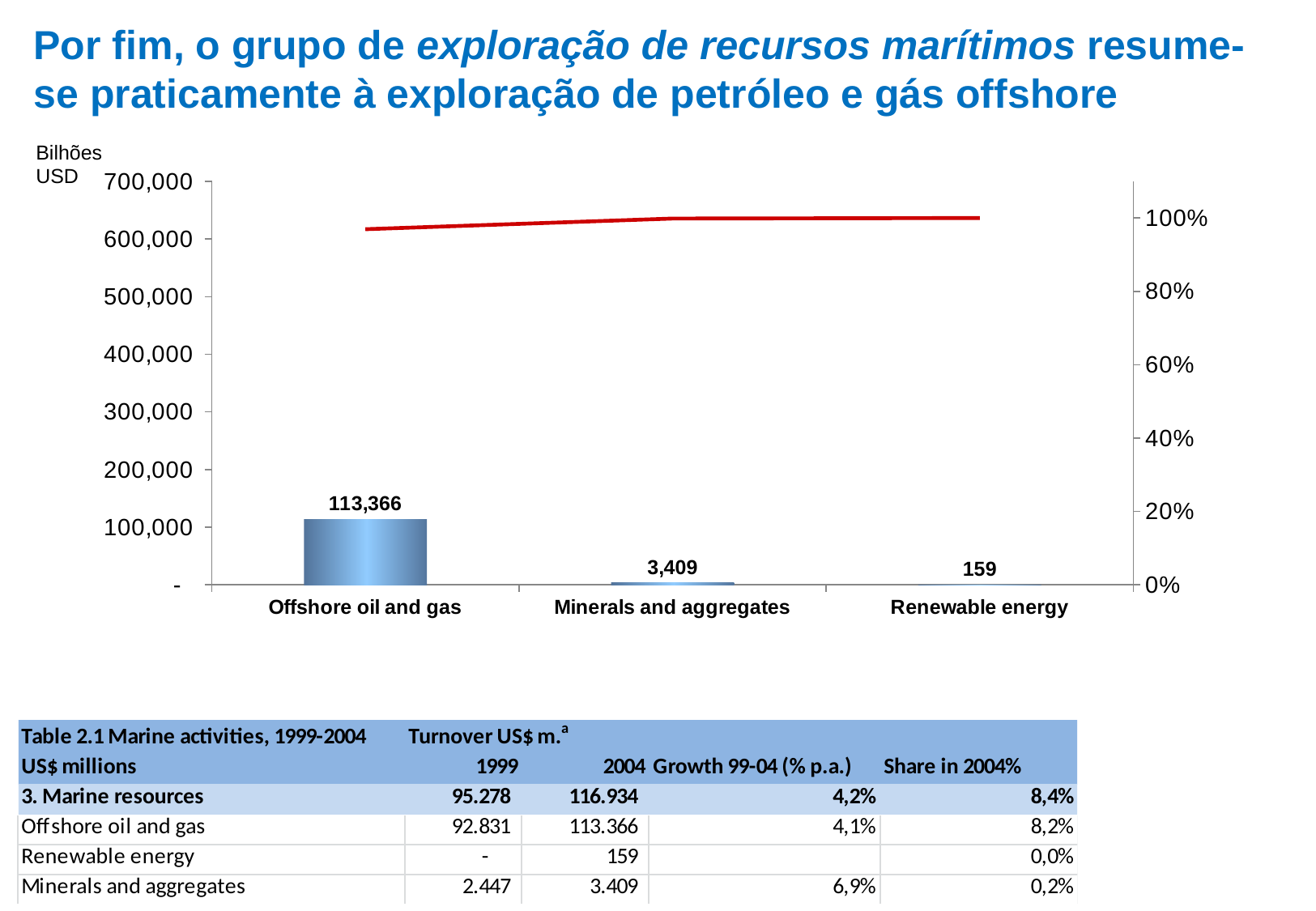
How many categories are shown on the x axis of the chart? 3 What kind of chart is shown on the slide? bar chart with a line What is the difference between the bar values for Minerals and aggregates and Renewable energy? 3,250 What is the value of the bar for Minerals and aggregates? 3,409 Which category has the lowest bar? Renewable energy Which category has the highest bar? Offshore oil and gas Is the bar value for Offshore oil and gas greater or less than 100,000? greater What is the value of the bar for Offshore oil and gas? 113,366 What is the difference between the bar values for Offshore oil and gas and Minerals and aggregates? 109,957 Which is larger, the bar for Minerals and aggregates or the bar for Renewable energy? Minerals and aggregates What is the value of the bar for Renewable energy? 159 What unit label is shown above the left axis of the chart? Bilhões USD